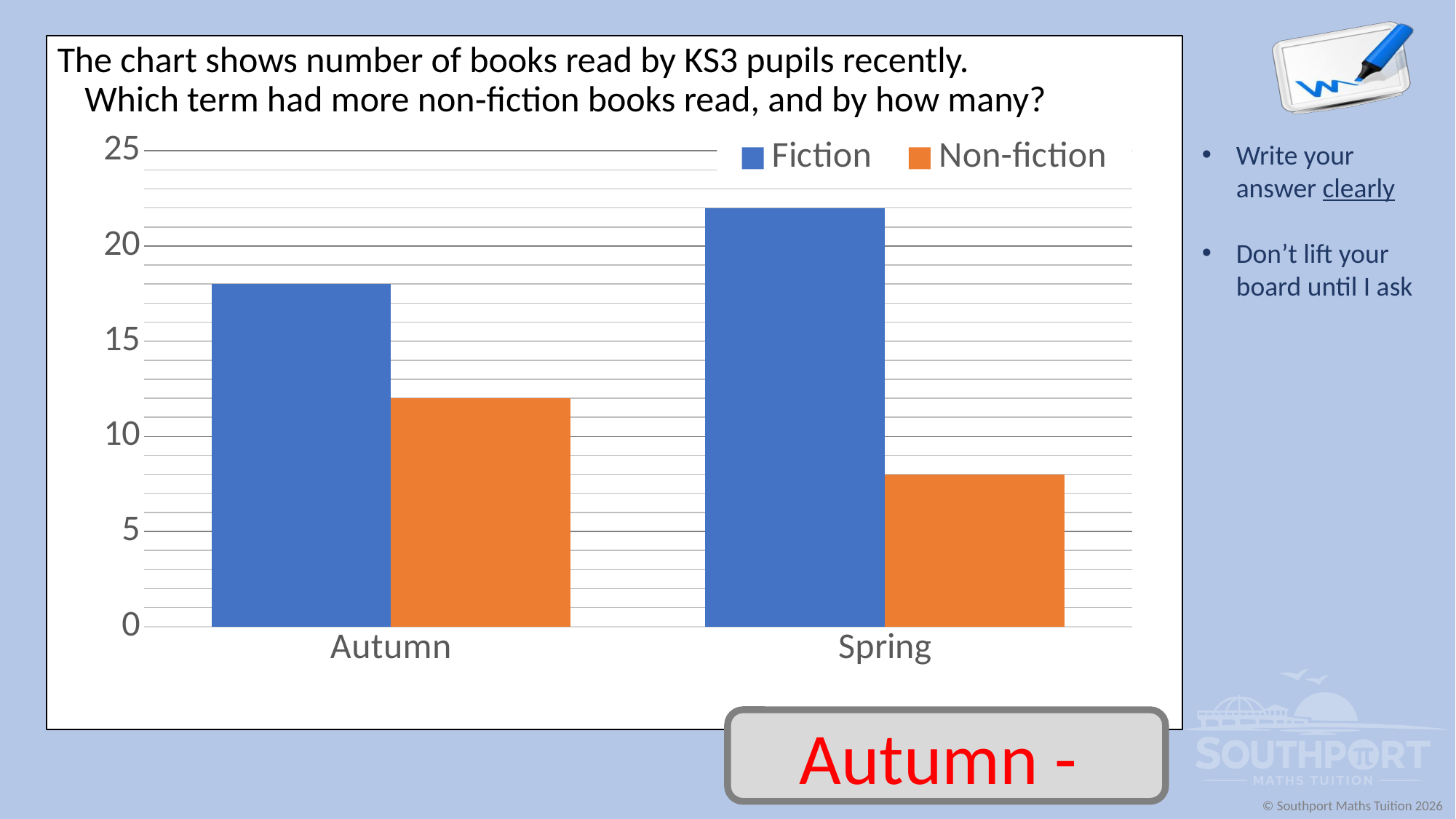
What colour represents Non-fiction in the legend? orange Which term had more non-fiction books read, Autumn or Spring? Autumn Is the value for Fiction in Autumn greater or less than 15? greater How many terms (categories) are shown on the x axis? 2 Which bar is the shortest in the chart? Non-fiction in Spring How many series does the legend list? 2 Does the number of non-fiction books read rise or fall from Autumn to Spring? fall Which bar is the tallest in the chart? Fiction in Spring What kind of chart is shown on the slide? bar chart Which term had more fiction books read, Autumn or Spring? Spring Is the value for Fiction in Spring greater or less than 20? greater Is the value for Non-fiction in Spring greater or less than 10? less